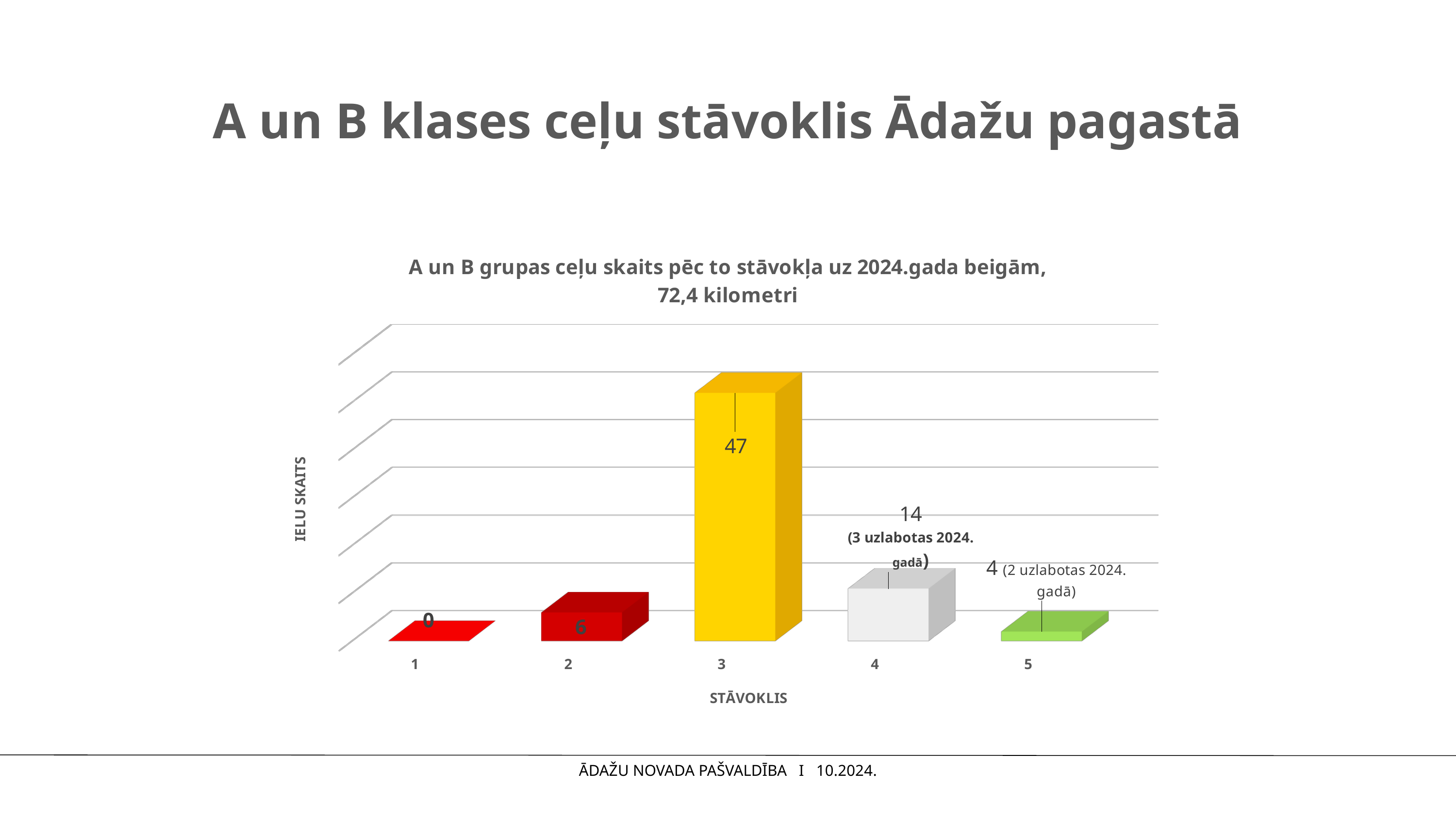
What kind of chart is shown on the slide? bar chart What is the value for condition category 3? 47 What colour is the bar for category 3? yellow Which is larger, the value for category 2 or the value for category 5? category 2 How many condition categories are shown on the x axis? 5 What is the title of the x axis? STĀVOKLIS What is the value for condition category 4? 14 What is the value for condition category 5? 4 What is the difference between the values for category 3 and category 4? 33 What is the value for condition category 2? 6 Which condition category has the highest number of streets? 3 Which condition category has the lowest number of streets? 1